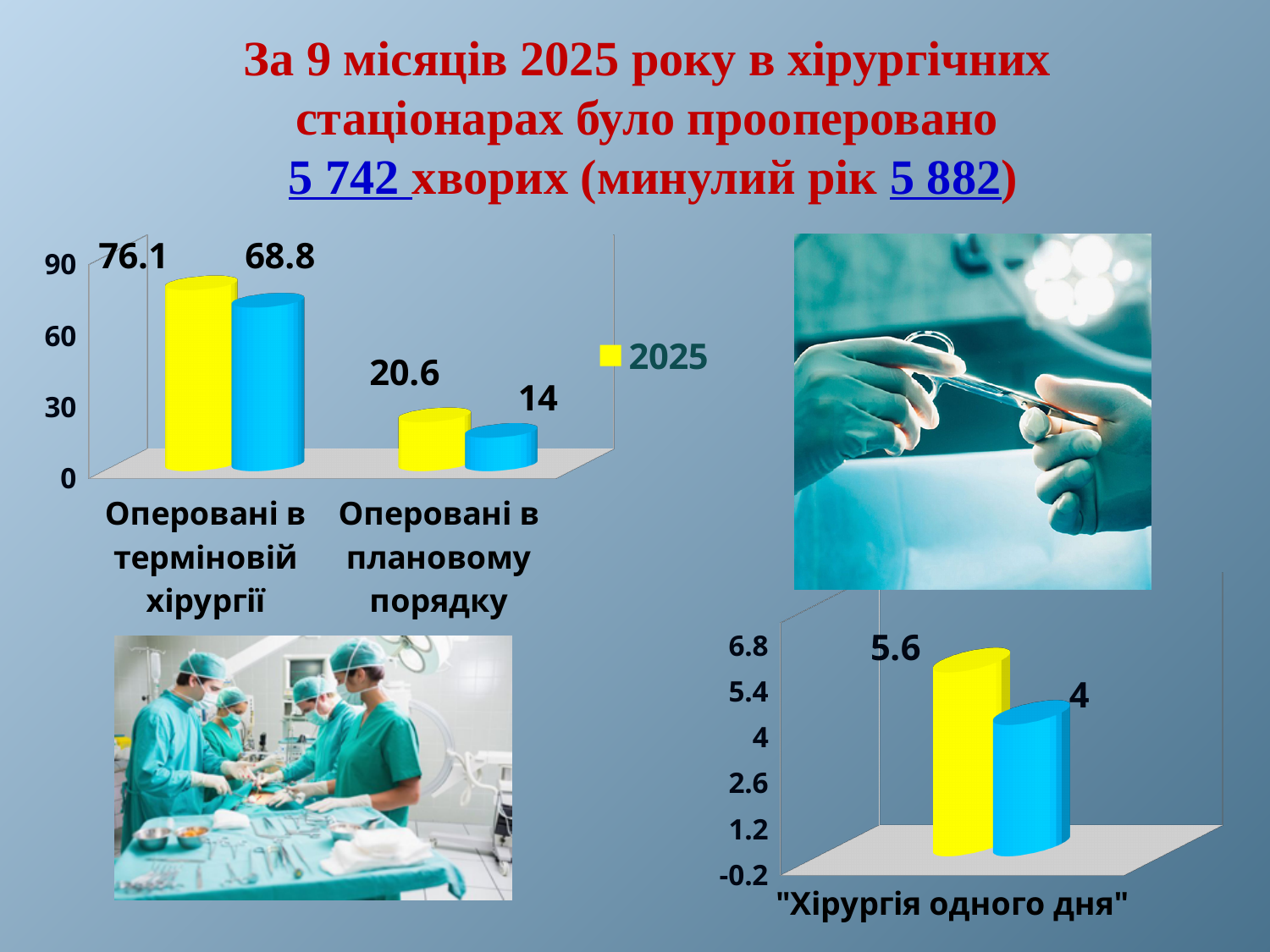
On the left chart, what is the difference between the yellow and blue bars for "Оперовані в терміновій хірургії"? 7.3 On the left chart, what is the value of the yellow (2025) bar for "Оперовані в терміновій хірургії"? 76.1 On the "Хірургія одного дня" chart, what is the value of the blue bar? 4 On the left chart, what is the value of the yellow (2025) bar for "Оперовані в плановому порядку"? 20.6 On the left chart, which category has the highest value? Оперовані в терміновій хірургії What kind of chart is the left chart? bar chart On the "Хірургія одного дня" chart, what is the value of the yellow bar? 5.6 On the left chart, how many categories are shown on the x axis? 2 On the left chart, what is the value of the blue bar for "Оперовані в плановому порядку"? 14 On the left chart, what is the value of the blue bar for "Оперовані в терміновій хірургії"? 68.8 On the "Хірургія одного дня" chart, what is the difference between the yellow and blue bars? 1.6 On the left chart, what is the difference between the yellow and blue bars for "Оперовані в плановому порядку"? 6.6